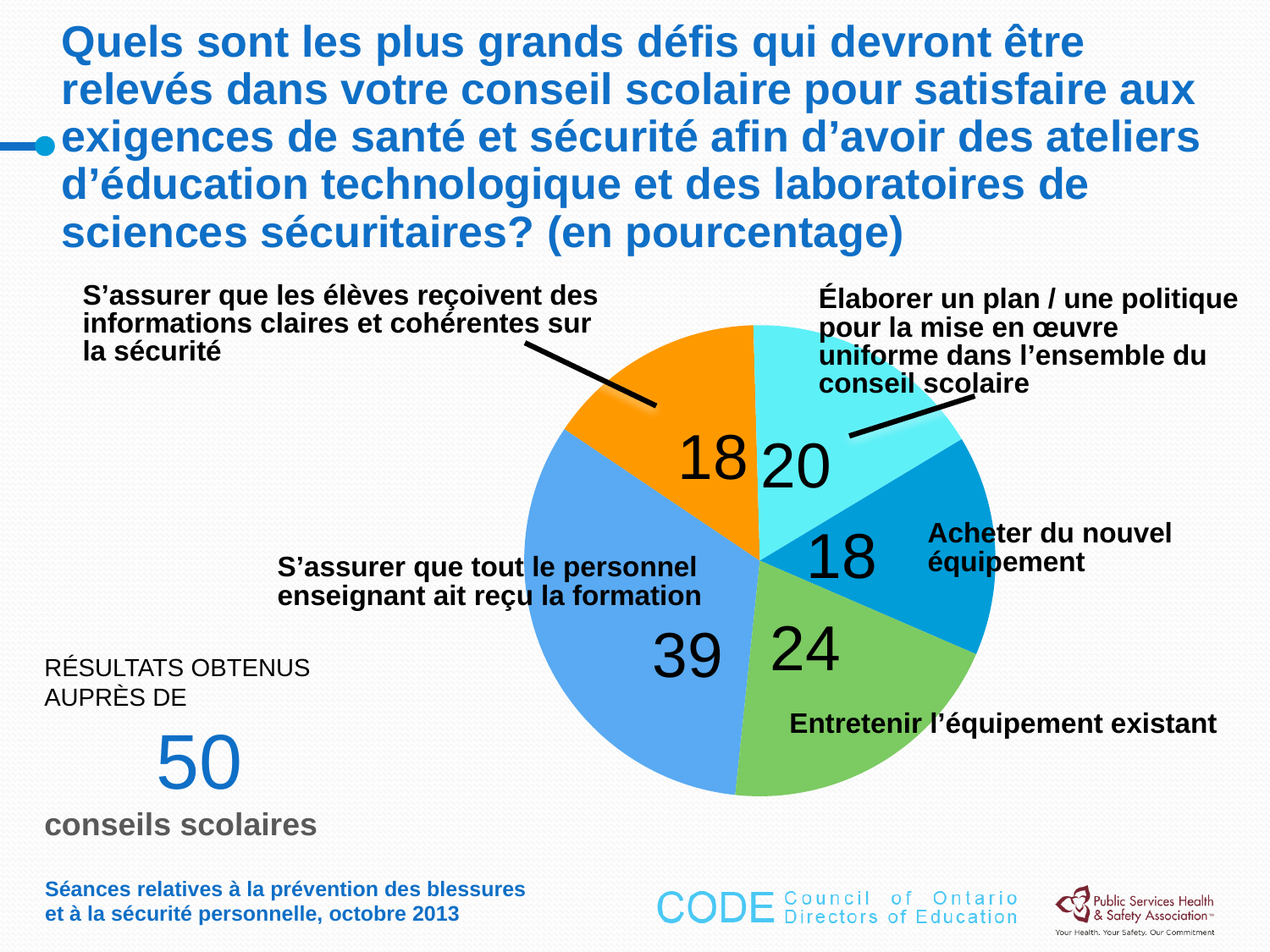
What value is shown for "Acheter du nouvel équipement"? 18 What value is shown for "S'assurer que les élèves reçoivent des informations claires et cohérentes sur la sécurité"? 18 Which is larger: the value for "Entretenir l'équipement existant" or the value for "Élaborer un plan / une politique pour la mise en œuvre uniforme dans l'ensemble du conseil scolaire"? Entretenir l'équipement existant What value is shown for "Entretenir l'équipement existant"? 24 What is the difference between the values for "S'assurer que tout le personnel enseignant ait reçu la formation" and "Entretenir l'équipement existant"? 15 How many school boards (conseils scolaires) provided the results shown on the slide? 50 What value is shown for "S'assurer que tout le personnel enseignant ait reçu la formation"? 39 What is the difference between the values for "Élaborer un plan / une politique pour la mise en œuvre uniforme dans l'ensemble du conseil scolaire" and "Acheter du nouvel équipement"? 2 How many slices does the pie chart have? 5 What value is shown for "Élaborer un plan / une politique pour la mise en œuvre uniforme dans l'ensemble du conseil scolaire"? 20 What kind of chart is shown on the slide? pie chart Which category has the largest slice of the pie? S'assurer que tout le personnel enseignant ait reçu la formation